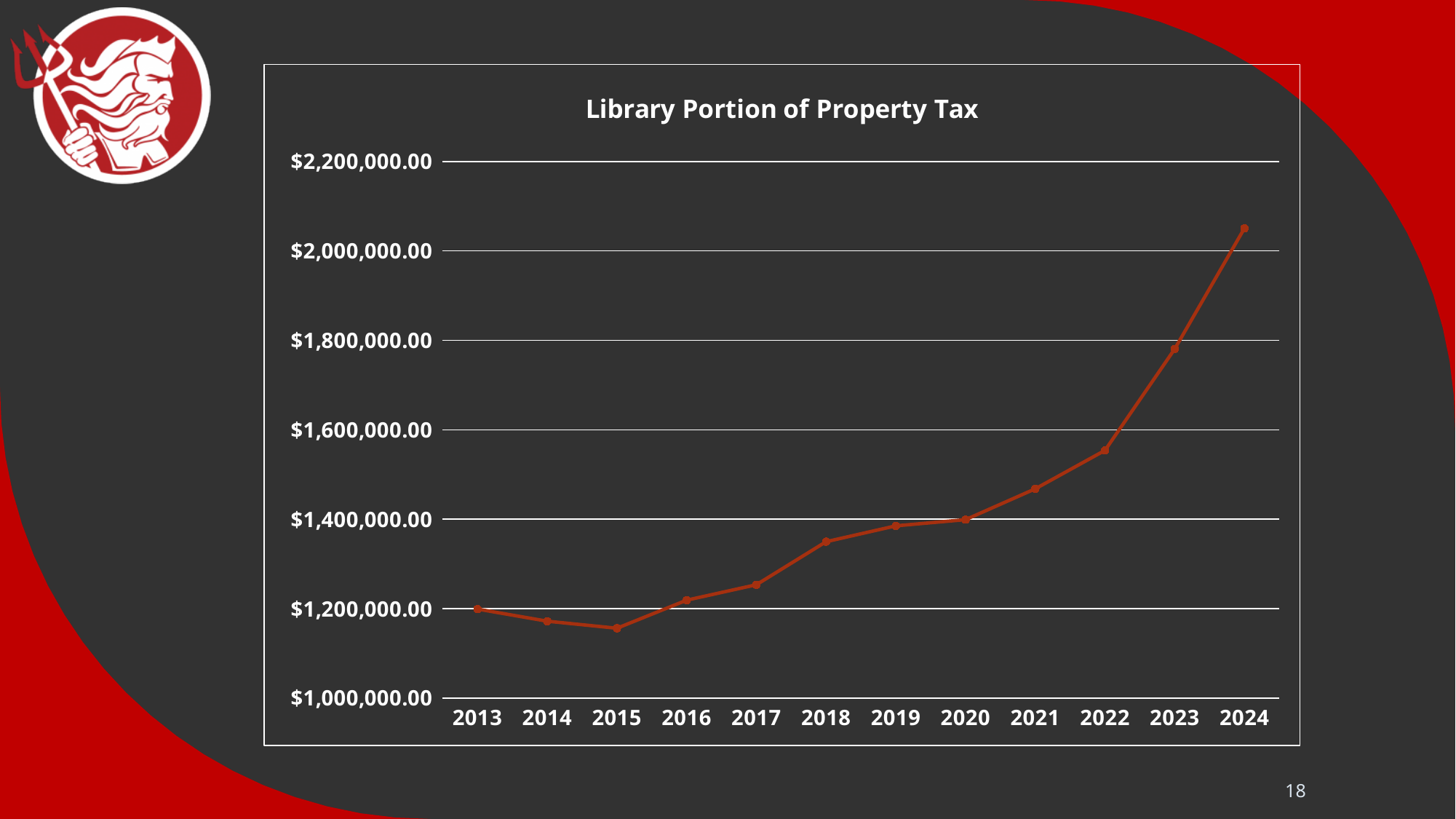
Which year has the lowest library portion of property tax? 2015 Is the value for 2022 greater or less than $1,600,000.00? less Which year has the highest library portion of property tax? 2024 What is the title of the chart? Library Portion of Property Tax What kind of chart is shown on the slide? Line chart How many years are plotted on the x axis of the chart? 12 Overall, do the values rise or fall from 2015 to 2024? rise Is the value for 2023 greater or less than $1,800,000.00? less Which year has a larger value, 2019 or 2023? 2023 Is the value for 2015 greater or less than $1,200,000.00? less